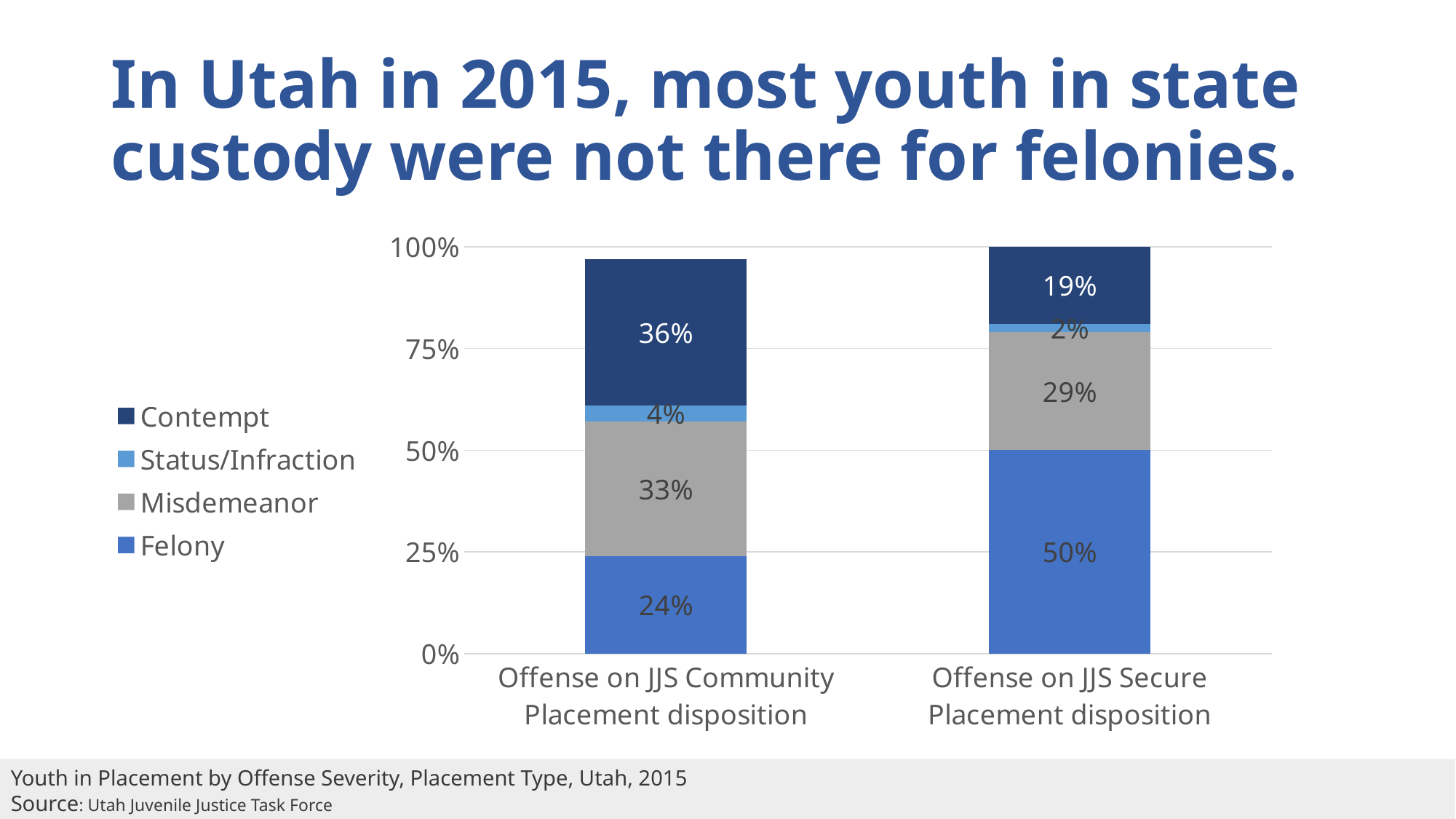
How many series does the legend list? 4 What is the Contempt value for the Offense on JJS Community Placement disposition bar? 36% What is the Felony share in the Offense on JJS Secure Placement disposition bar? 50% How much larger is the Felony share in the Secure Placement bar than in the Community Placement bar? 26 percentage points Which offense category is the largest segment in the Offense on JJS Community Placement disposition bar? Contempt How many placement disposition categories are shown on the x axis? 2 What is the Misdemeanor value for the Offense on JJS Secure Placement disposition bar? 29% What kind of chart is shown on the slide? Stacked bar chart Which offense category is the smallest segment in the Offense on JJS Secure Placement disposition bar? Status/Infraction What percentage of youth in the Offense on JJS Community Placement disposition bar were there for a felony? 24% Which bar has the larger Contempt share, Community Placement or Secure Placement? Offense on JJS Community Placement disposition What is the Status/Infraction value for the Offense on JJS Secure Placement disposition bar? 2%